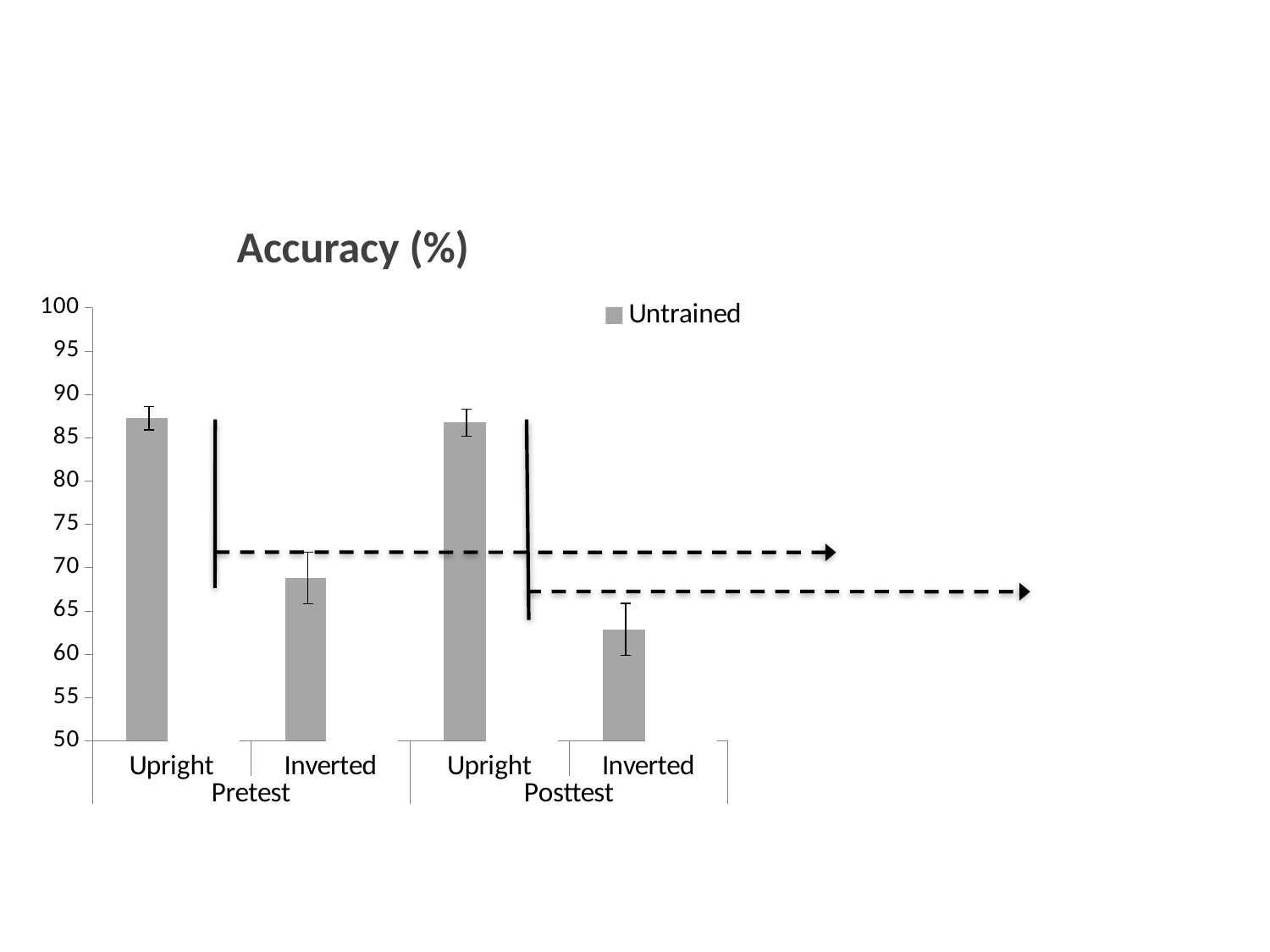
Which is larger, the Inverted accuracy at Pretest or at Posttest? Pretest Is the value for Posttest Inverted greater or less than 65? less How many bars are plotted in the chart? 4 Is the value for Pretest Upright greater or less than 85? greater What kind of chart is shown on the slide? Bar chart Is the value for Posttest Upright greater or less than 90? less What is the title of the chart? Accuracy (%) Which bar has the lowest accuracy? Posttest Inverted How many series does the legend list? 1 What series does the legend list? Untrained Does the Inverted accuracy rise or fall from Pretest to Posttest? Fall